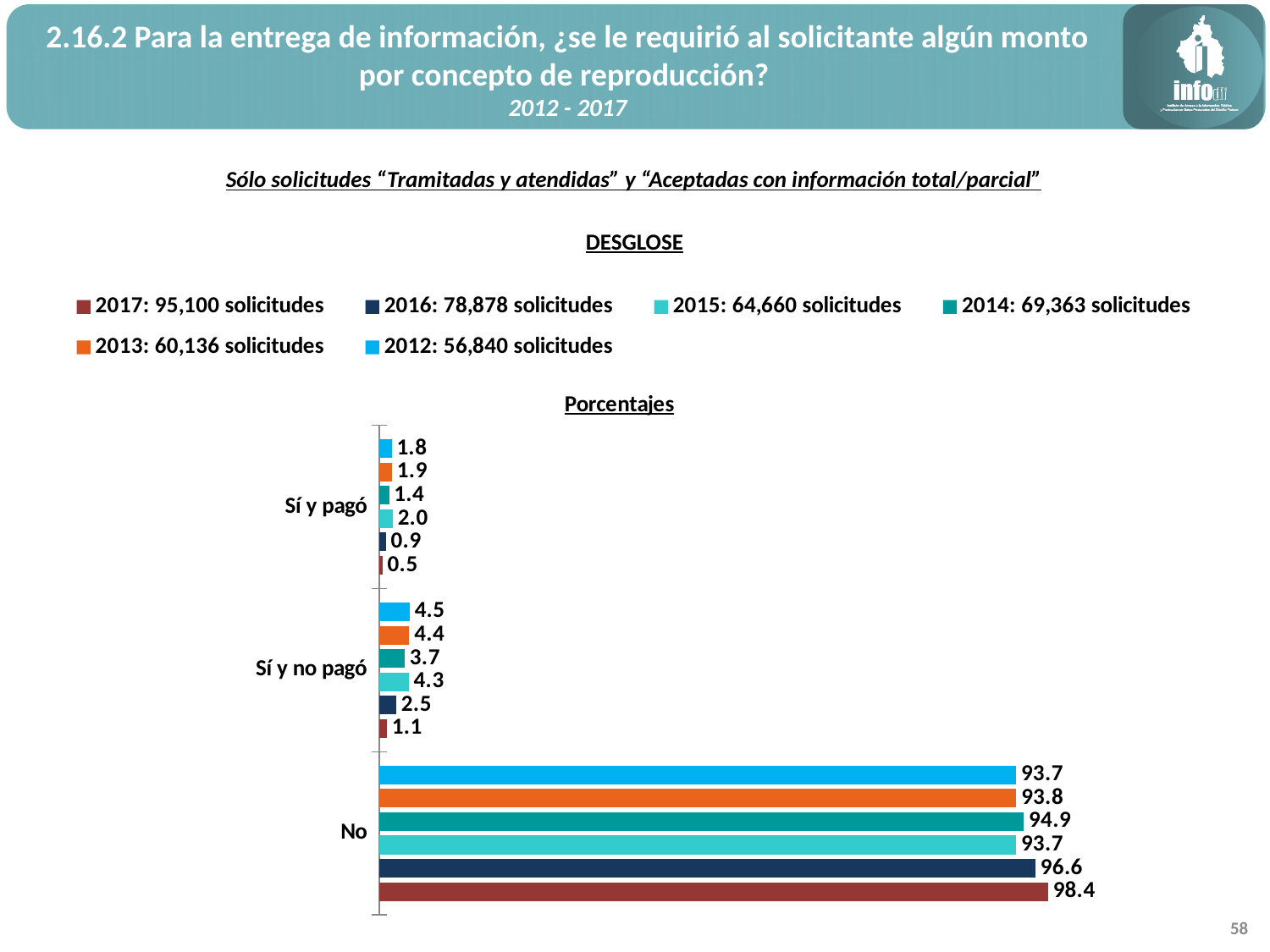
What is the difference between the 2013 and 2017 values in the "Sí y no pagó" category? 3.3 What is the value for 2017 in the "No" category? 98.4 What is the value for 2015 in the "Sí y pagó" category? 2.0 What is the difference between the 2017 and 2012 values in the "No" category? 4.7 What is the value for 2012 in the "Sí y no pagó" category? 4.5 Which is larger in the "Sí y no pagó" category: the value for 2014 or the value for 2016? 2014 How many series does the legend list? 6 Which year has the highest value in the "No" category? 2017 According to the legend, how many solicitudes were there in 2016? 78,878 solicitudes What kind of chart is shown on the slide? Bar chart Which year has the lowest value in the "Sí y pagó" category? 2017 How many categories are shown on the chart? 3